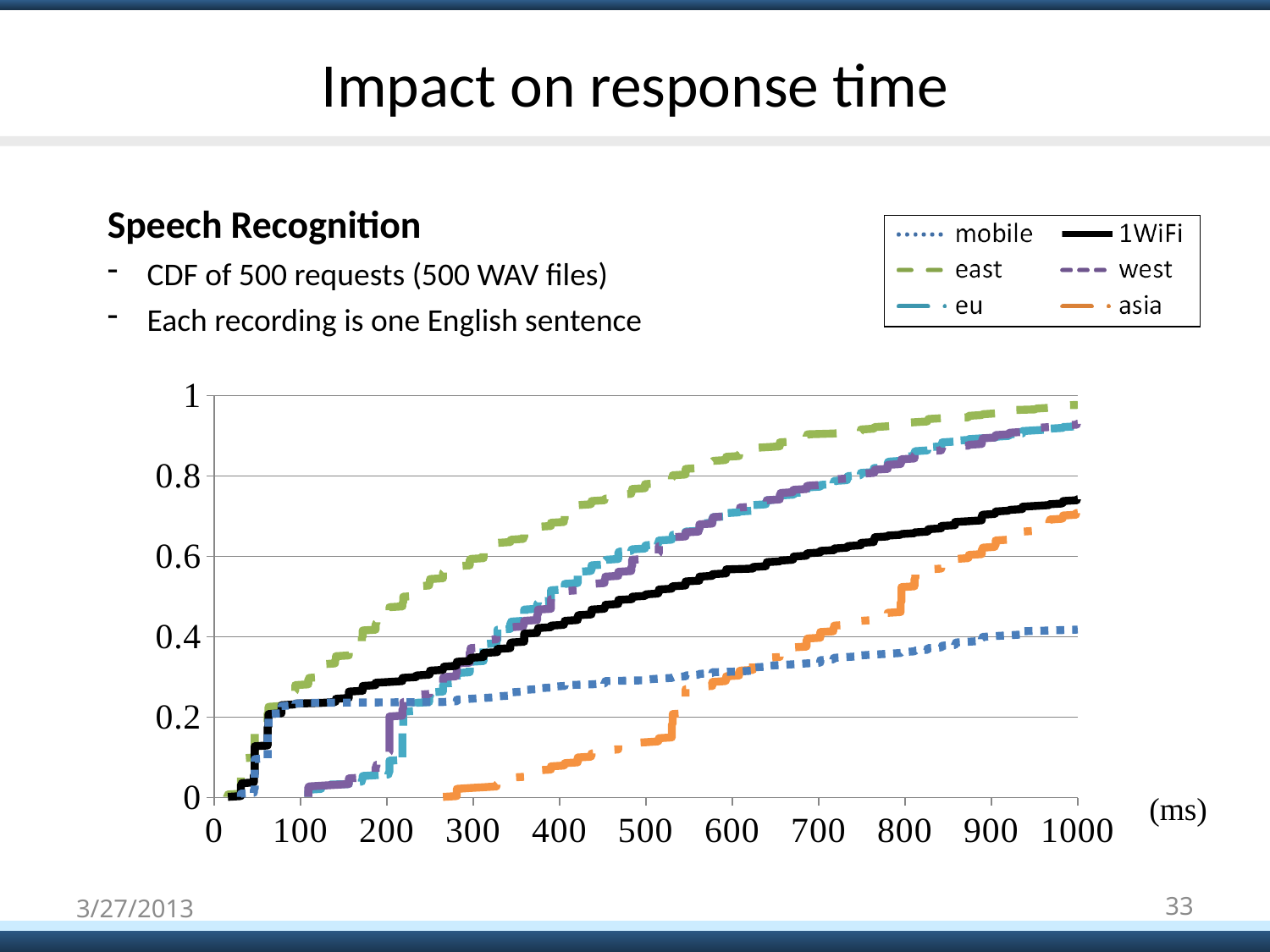
Is the value for mobile at 1000 ms greater or less than 0.6? less Do the values of the east series rise or fall as the x axis increases? rise Is the value for east at 1000 ms greater or less than 0.8? greater What unit is shown for the x axis? ms Which series has the lowest value at 1000 ms? mobile Is the value for asia at 400 ms greater or less than 0.2? less At 1000 ms, which series has the larger value, 1WiFi or mobile? 1WiFi At 500 ms, which series has the larger value, east or asia? east What kind of chart is shown on the slide? line chart Which series reaches the highest value at 1000 ms? east How many series does the legend list? 6